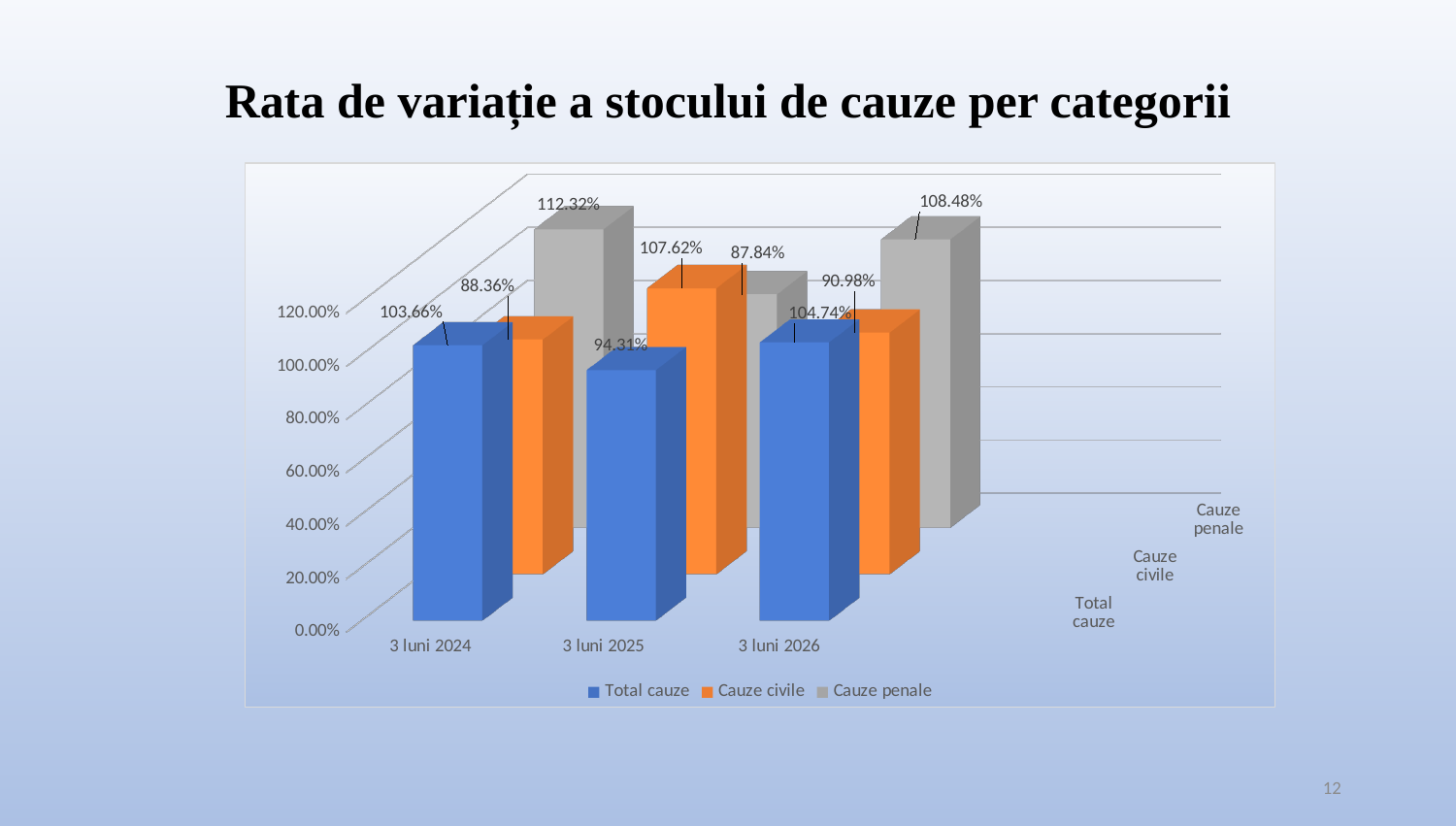
Which category has the lowest value for Total cauze? 3 luni 2025 Which category has the highest value for Cauze penale? 3 luni 2024 What is the value for Cauze civile in 3 luni 2025? 107.62% What is the title of the chart on the slide? Rata de variație a stocului de cauze per categorii How many series does the legend list? 3 What kind of chart is shown on the slide? Bar chart What is the difference between Cauze penale and Cauze civile in 3 luni 2024? 23.96% What is the value for Total cauze in 3 luni 2024? 103.66% What is the value for Cauze civile in 3 luni 2026? 90.98% What is the value for Cauze penale in 3 luni 2025? 87.84% Which is larger in 3 luni 2026: Total cauze or Cauze penale? Cauze penale How many categories are shown on the x axis? 3